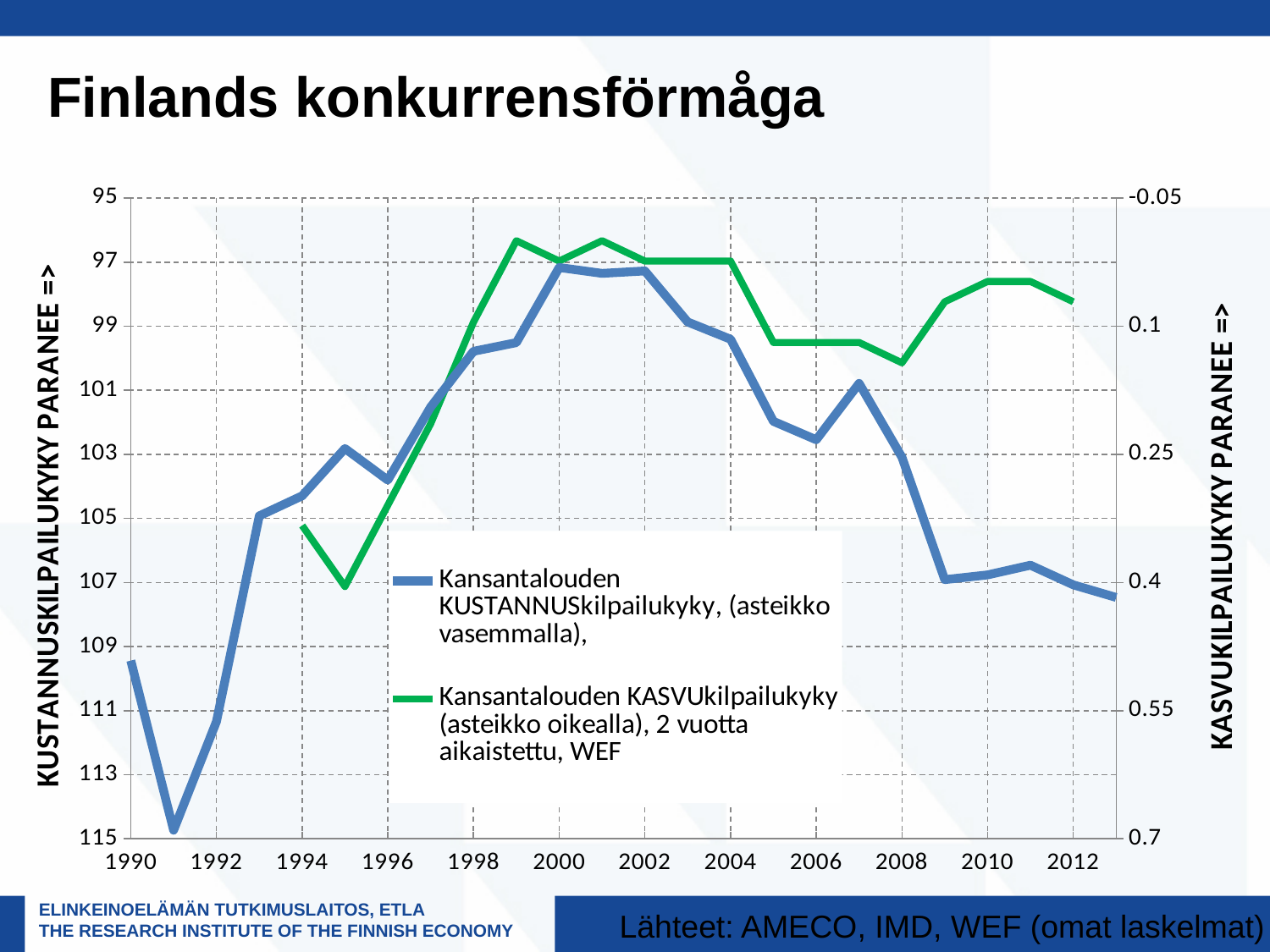
What kind of chart is shown on the slide? line chart Which series is drawn in green according to the legend? Kansantalouden KASVUkilpailukyky (asteikko oikealla), 2 vuotta aikaistettu, WEF Between 1991 and 1993, does the blue KUSTANNUSkilpailukyky line move up or down on the chart? up Is the value of the blue KUSTANNUSkilpailukyky line in 2009 greater or less than 105 on the left axis? greater Between 2007 and 2009, does the blue KUSTANNUSkilpailukyky line move up or down on the chart? down Is the value of the green KASVUkilpailukyky line in 1995 greater or less than 0.25 on the right axis? greater Is the value of the green KASVUkilpailukyky line in 1999 greater or less than 0.1 on the right axis? less How many series does the legend list? 2 What is the title of the slide above the chart? Finlands konkurrensförmåga